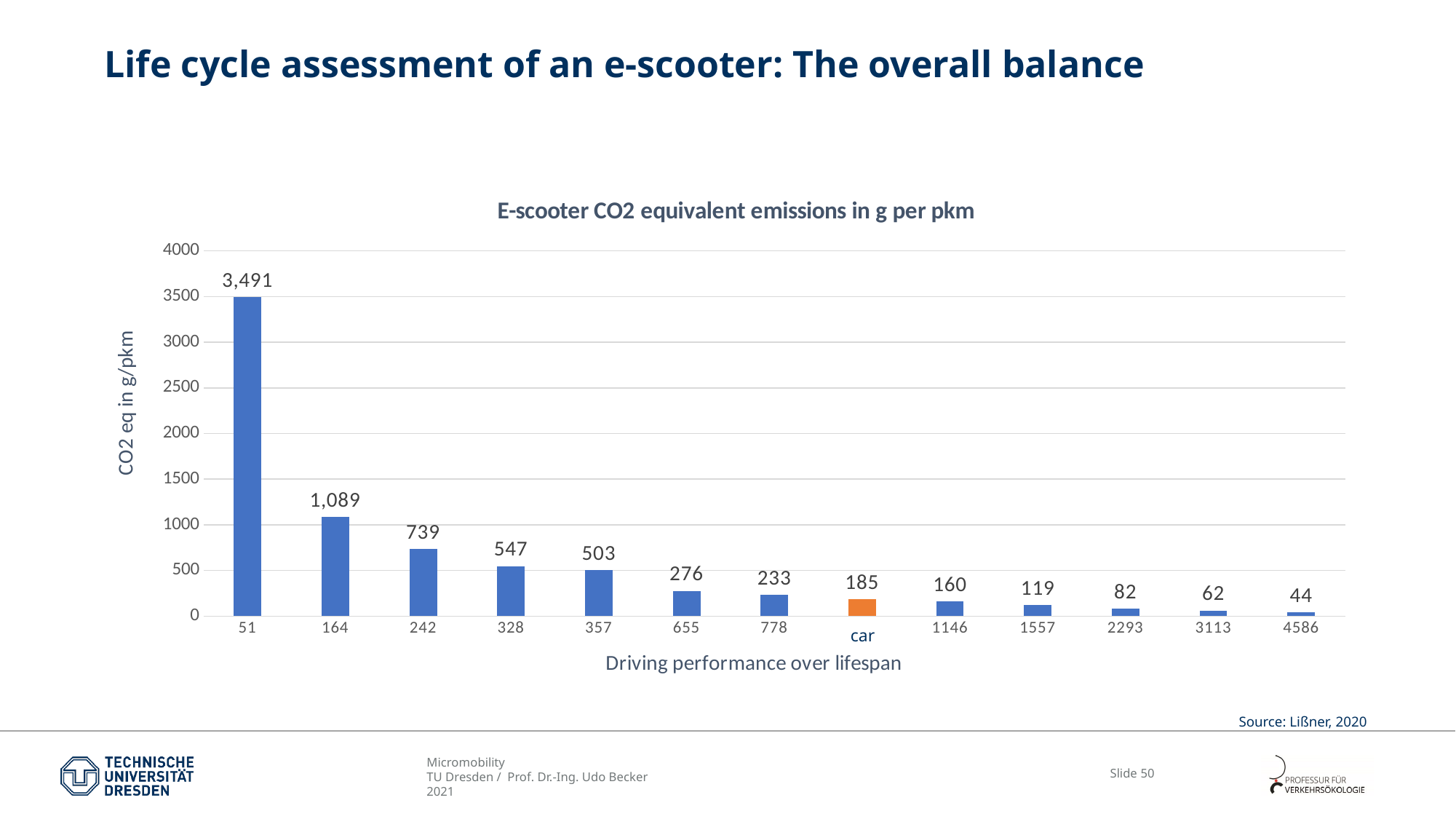
What is the difference between the values for driving performance 164 and 242? 350 What is the CO2 equivalent emission value for the car? 185 What kind of chart is shown on the slide? Bar chart Which category has the lowest CO2 equivalent emissions? 4586 Which is larger, the value for driving performance 778 or the value for the car? 778 What is the CO2 equivalent emission value for a driving performance of 4586? 44 Which category has the highest CO2 equivalent emissions? 51 How many bars are shown in the chart? 13 Do the e-scooter values rise or fall as driving performance over lifespan increases along the x axis? Fall Is the value for driving performance 328 greater or less than 500? greater What is the CO2 equivalent emission value for a driving performance of 51? 3,491 Which bar is coloured orange instead of blue? car